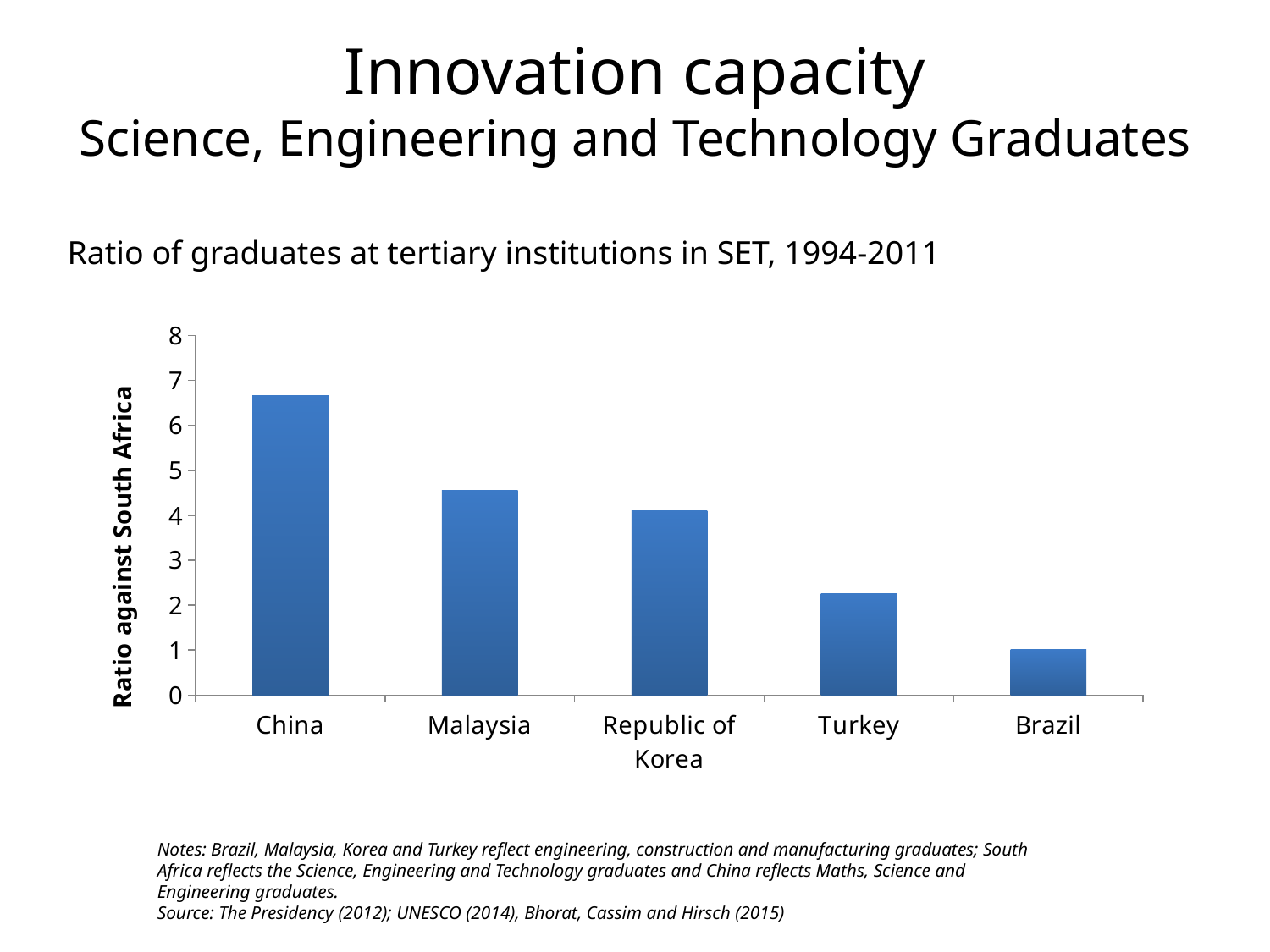
Is the value for China greater or less than 6? greater Which country has the highest ratio against South Africa? China Which country has the lowest ratio against South Africa? Brazil How many countries are shown on the x axis of the chart? 5 Which has a larger ratio, Republic of Korea or Brazil? Republic of Korea Do the bar values rise or fall from left to right across the x axis? fall Is the value for Turkey greater or less than 3? less What is the label on the vertical axis of the chart? Ratio against South Africa What kind of chart is shown on the slide? bar chart Which has a larger ratio, Malaysia or Turkey? Malaysia Is the value for Malaysia greater or less than 5? less